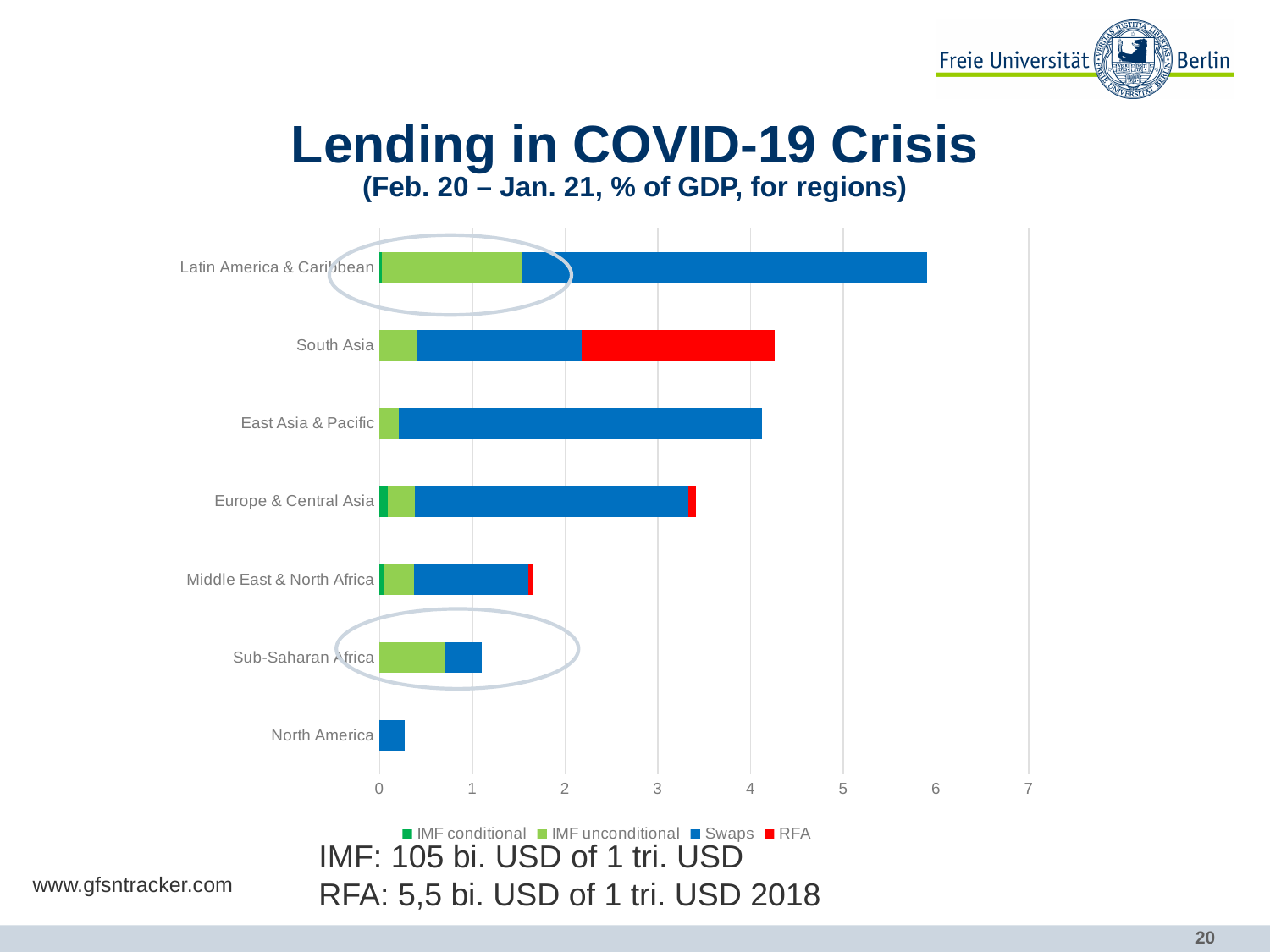
How many series does the legend list? 4 How many regions are plotted in the chart? 7 Which region has the lowest total lending as % of GDP? North America Is the total value for Europe & Central Asia greater or less than 4? less Is the total value for South Asia greater or less than 4? greater Which region has the largest RFA segment? South Asia Which region has the highest total lending as % of GDP? Latin America & Caribbean Is the total value for Middle East & North Africa greater or less than 2? less Which has a larger total bar, Latin America & Caribbean or South Asia? Latin America & Caribbean What kind of chart is shown on the slide? Bar chart